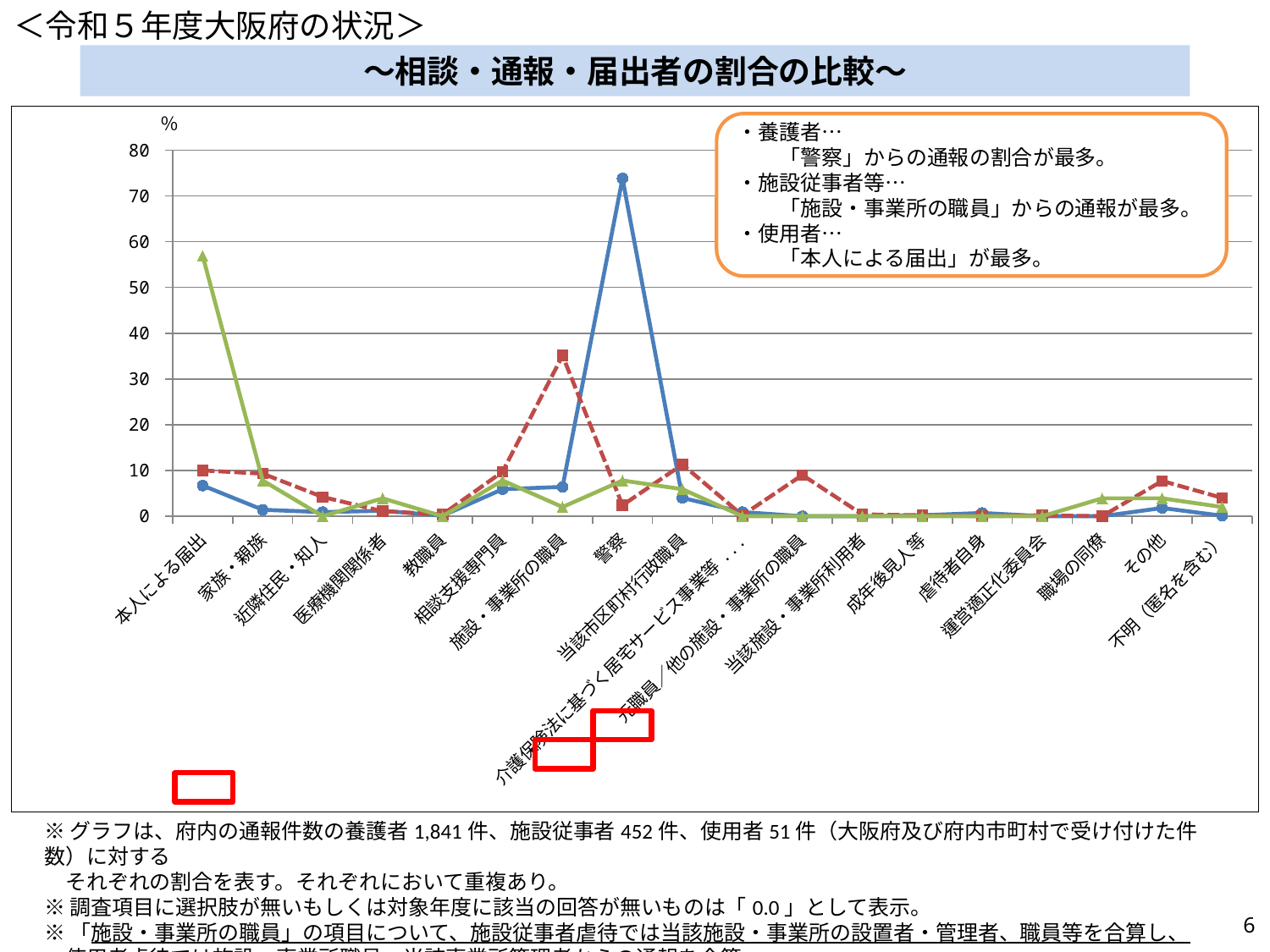
At 本人による届出, which line has the larger value, the green line or the blue line? the green line At 警察, which line has the larger value, the blue line or the red dashed line? the blue line Which category has the highest value on the green line? 本人による届出 Which category has the highest value on the red dashed line? 施設・事業所の職員 Is the value of the blue line for 警察 greater or less than 70? greater What kind of chart is shown on the slide? line chart Is the value of the red dashed line for 施設・事業所の職員 greater or less than 30? greater How many categories are shown along the x axis of the chart? 18 Is the value of the green line for 本人による届出 greater or less than 50? greater How many lines are plotted on the chart? 3 Which category has the highest value on the solid blue line? 警察 What is the title of the chart? 〜相談・通報・届出者の割合の比較〜